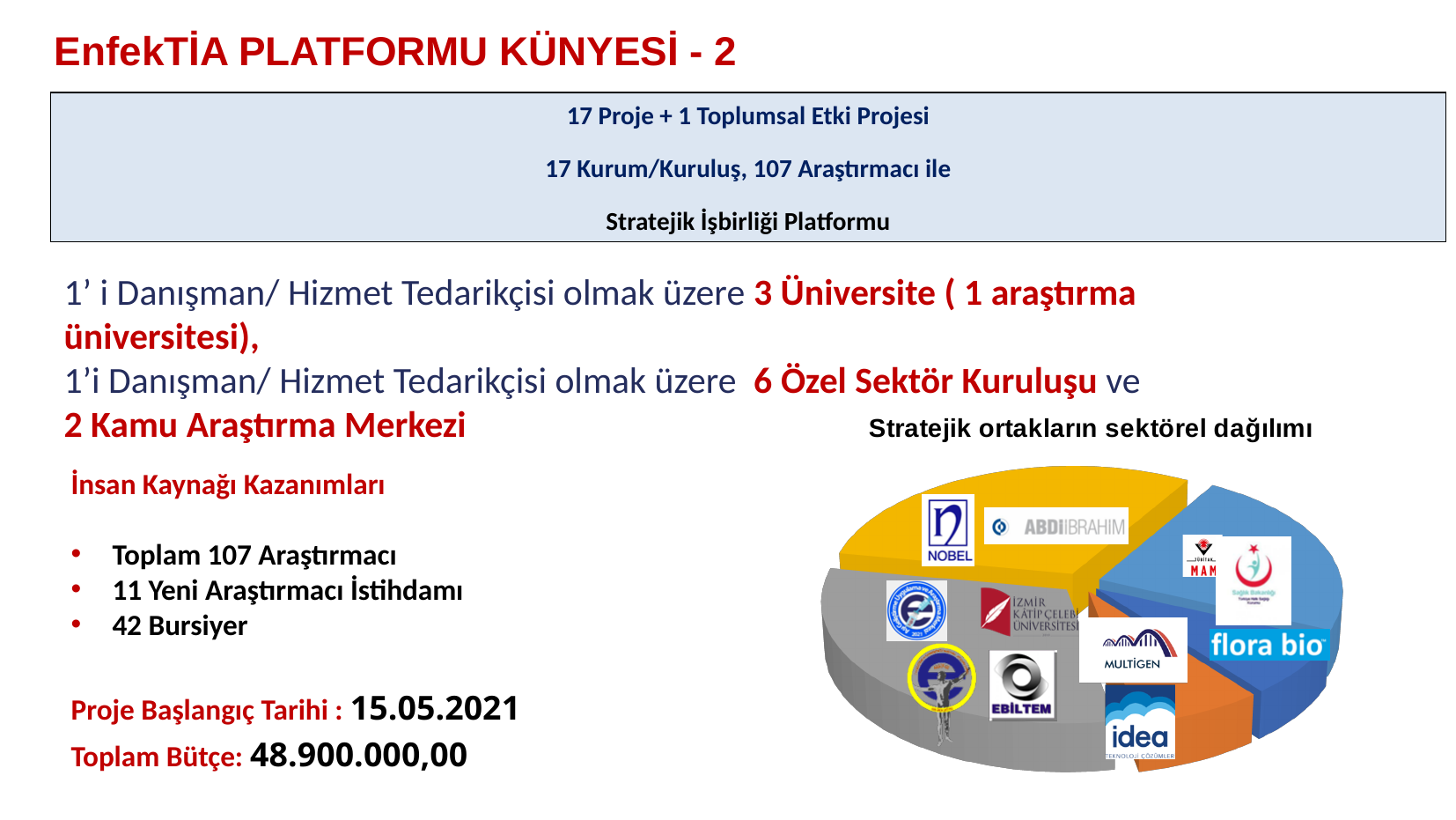
Is the gray slice of the pie chart larger or smaller than the orange slice? larger Which colour slice of the pie chart is the largest? gray What kind of chart is shown on the slide? pie chart What is the title of the pie chart on the slide? Stratejik ortakların sektörel dağılımı How many slices does the pie chart have? 4 Which colour slice of the pie chart is the smallest? orange